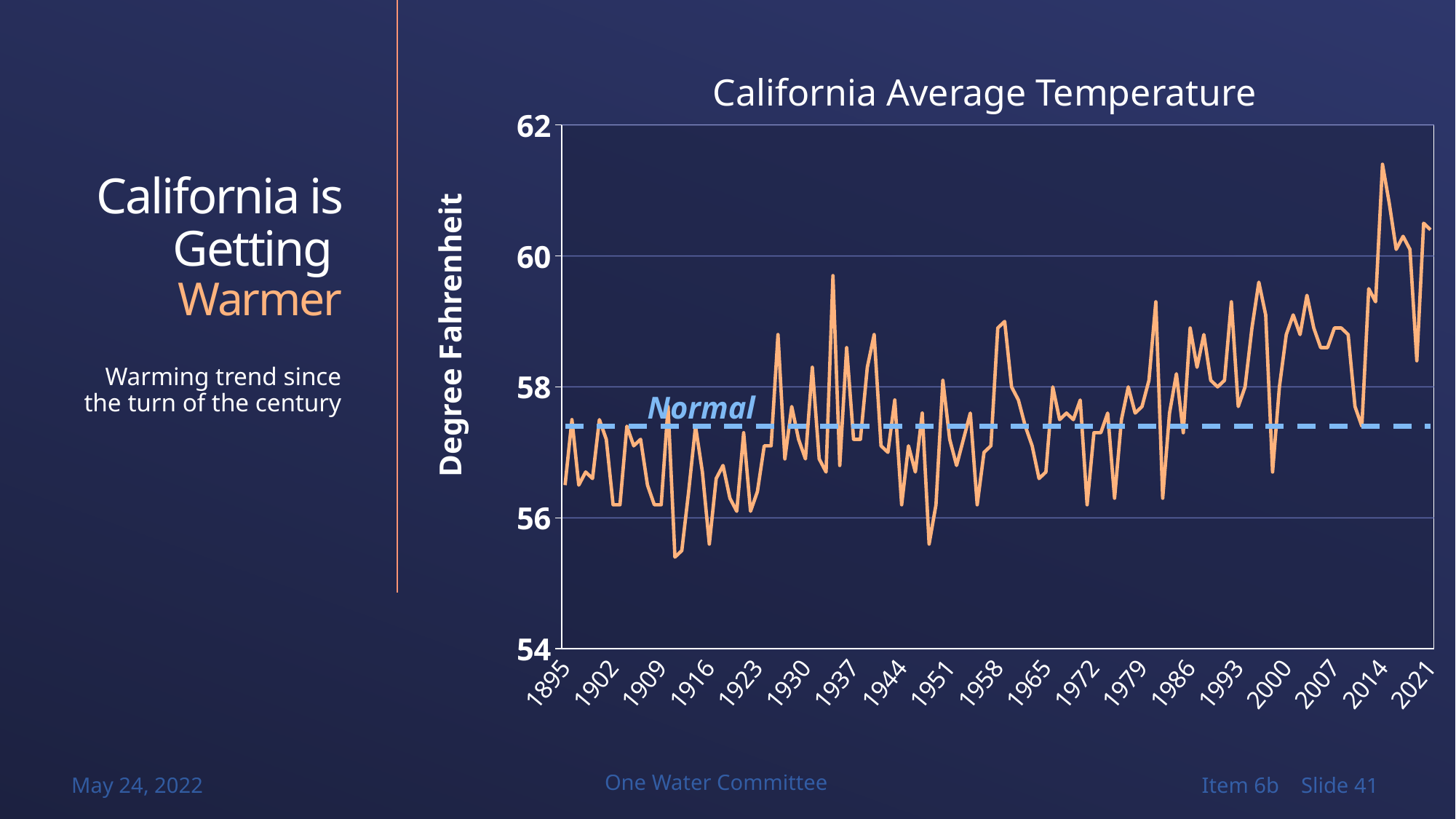
What kind of chart is shown on the slide? line chart Which year has the highest temperature on the chart? 2014 Is the value for 1951 greater or less than 58? less Is the Normal dashed line above or below 58 on the y axis? below Is the value for 1895 greater or less than 58? less How many year labels are shown on the x axis? 19 What is the highest value shown on the y axis? 62 Overall, do the temperature values rise or fall from 1895 to 2021? rise What is the title of the chart? California Average Temperature What label is given to the dashed horizontal line on the chart? Normal